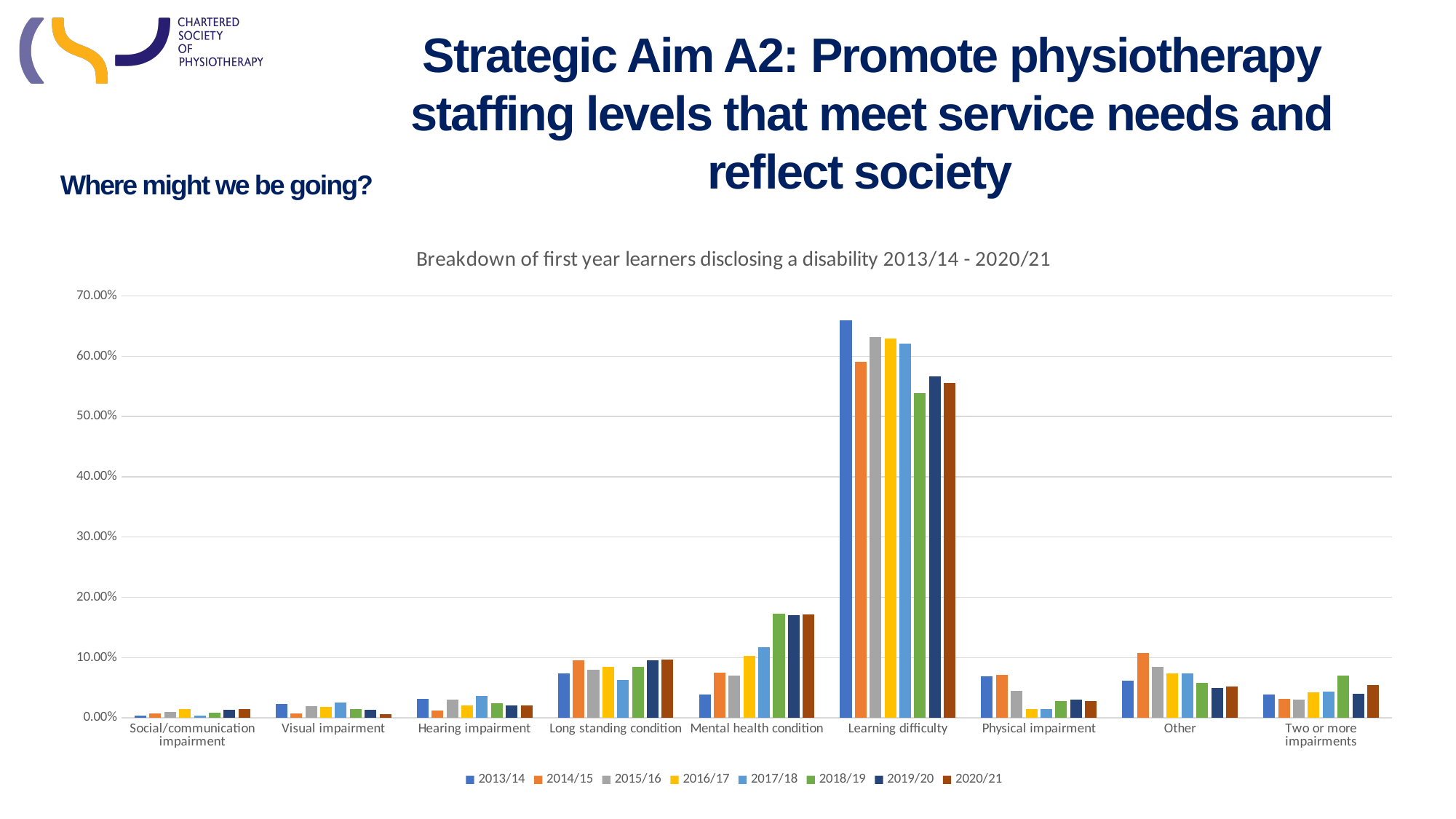
How many disability categories are shown on the x axis? 9 Which category has the lowest values across all years? Social/communication impairment Which category has the highest values across all years? Learning difficulty Is the value for Learning difficulty in 2018/19 greater or less than 60.00%? less Is the value for Learning difficulty in 2013/14 greater or less than 60.00%? greater How many series does the legend list? 8 Do the values for Mental health condition rise or fall from 2013/14 to 2020/21? rise What kind of chart is shown on the slide? Bar chart For Mental health condition, which is larger: the 2013/14 value or the 2020/21 value? 2020/21 What is the title of the chart? Breakdown of first year learners disclosing a disability 2013/14 - 2020/21 Is the value for Mental health condition in 2018/19 greater or less than 10.00%? greater